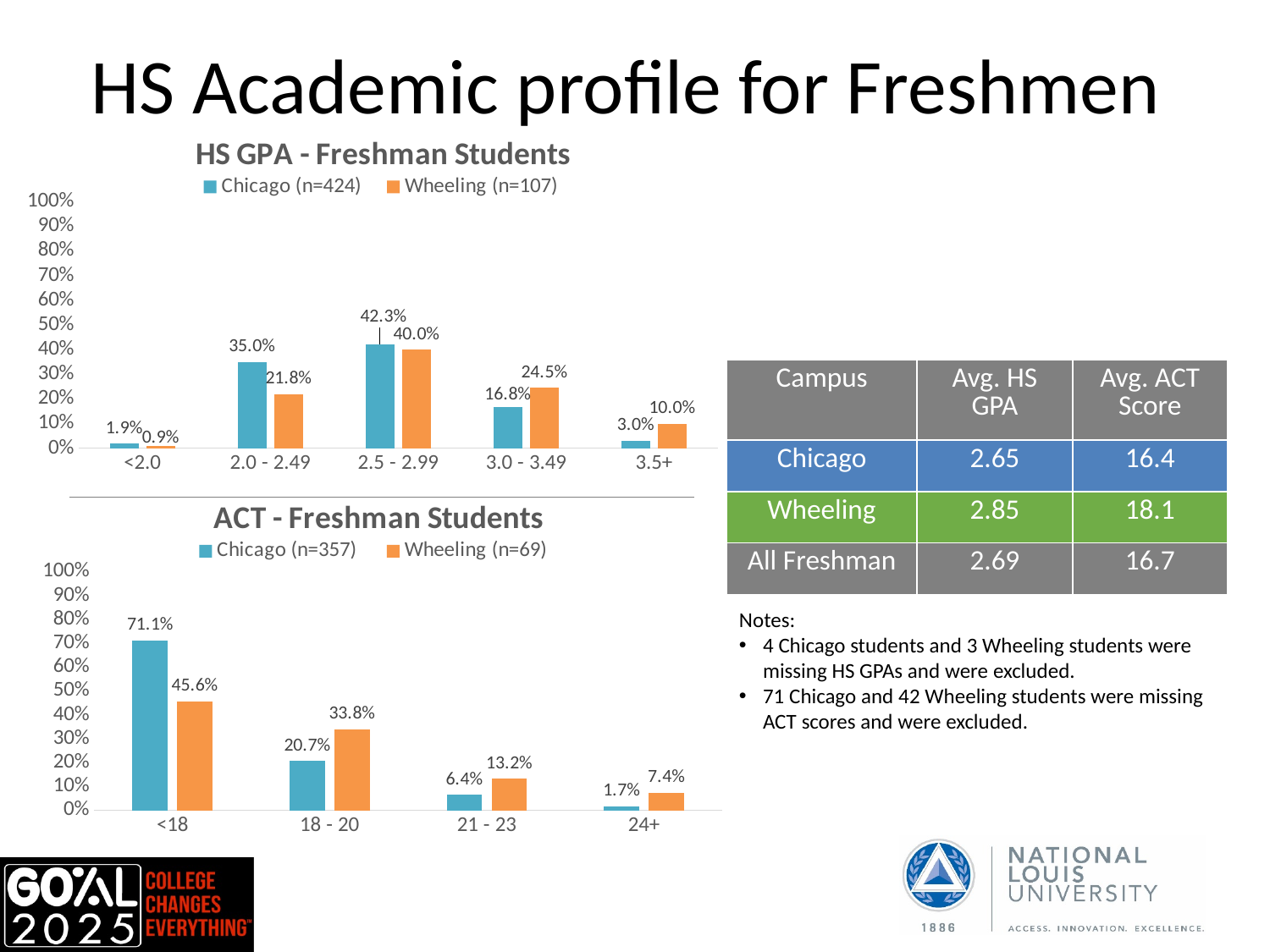
In the 'HS GPA - Freshman Students' chart, what is the difference between Chicago and Wheeling in the 2.0 - 2.49 category? 13.2% In the 'HS GPA - Freshman Students' chart, which GPA category has the lowest value for Wheeling? <2.0 In the 'HS GPA - Freshman Students' chart, how many GPA categories are shown on the x axis? 5 In the 'HS GPA - Freshman Students' chart, what is the value for Chicago in the 2.5 - 2.99 category? 42.3% In the 'ACT - Freshman Students' chart, what is the value for Wheeling in the 18 - 20 category? 33.8% In the 'HS GPA - Freshman Students' chart, what is the value for Wheeling in the 3.0 - 3.49 category? 24.5% In the 'ACT - Freshman Students' chart, how many series does the legend list? 2 In the 'ACT - Freshman Students' chart, what is the value for Chicago in the <18 category? 71.1% What kind of chart is the 'ACT - Freshman Students' chart? Bar chart In the 'HS GPA - Freshman Students' chart, which GPA category has the highest value for Chicago? 2.5 - 2.99 In the 'ACT - Freshman Students' chart, what is the difference between Chicago and Wheeling in the <18 category? 25.5% In the 'ACT - Freshman Students' chart, which is larger in the 21 - 23 category, Chicago or Wheeling? Wheeling